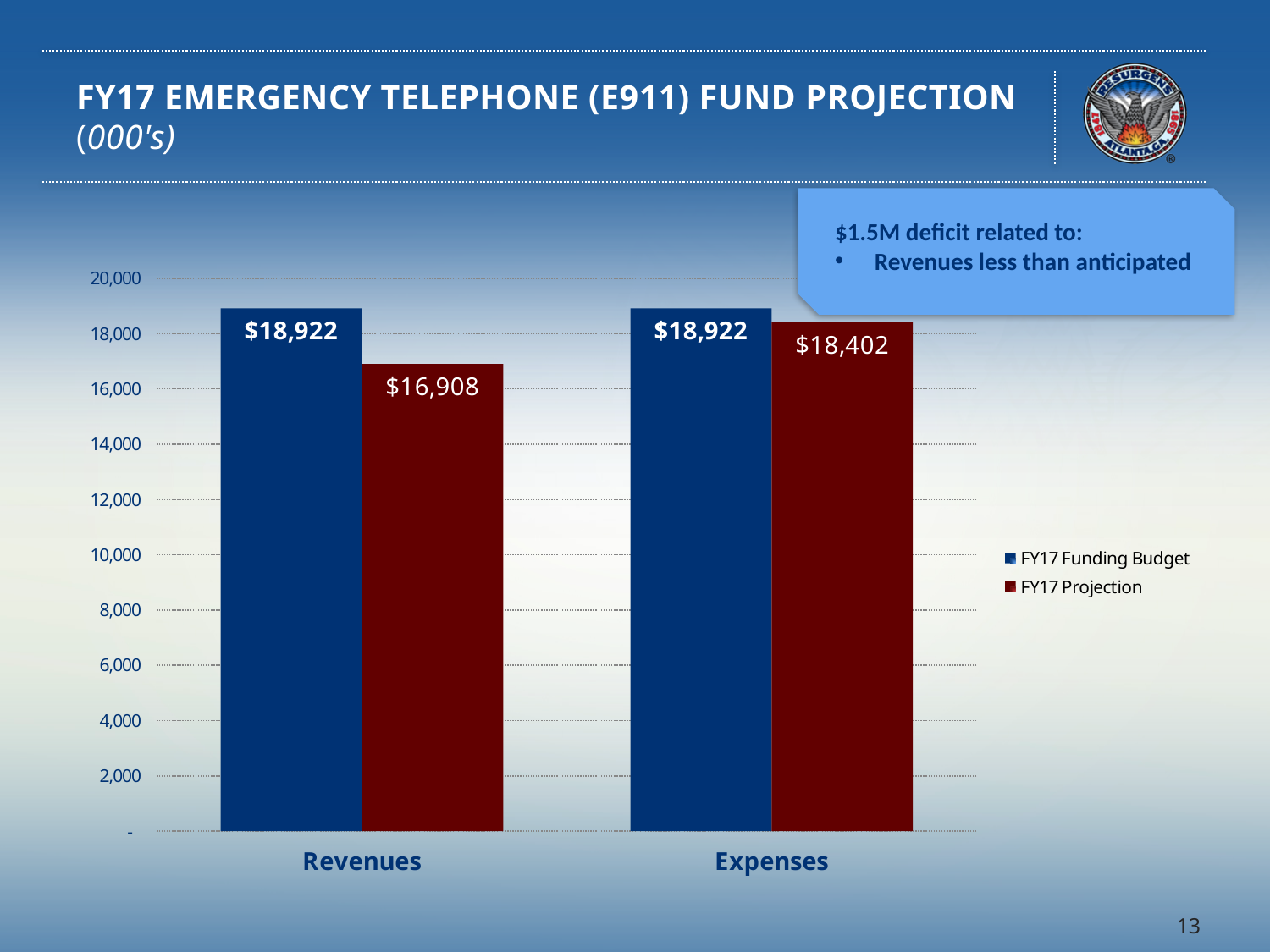
How many series does the legend list? 2 What is the FY17 Projection value for Expenses? $18,402 How many categories are shown on the x axis? 2 What is the difference between the FY17 Funding Budget and FY17 Projection for Revenues? $2,014 What kind of chart is shown on the slide? Bar chart Which category has the lowest FY17 Projection value? Revenues What is the FY17 Projection value for Revenues? $16,908 What is the FY17 Funding Budget value for Revenues? $18,922 Is the FY17 Projection value for Revenues greater or less than 18,000? less What is the difference between the FY17 Funding Budget and FY17 Projection for Expenses? $520 What is the FY17 Funding Budget value for Expenses? $18,922 Which is larger, the FY17 Projection for Revenues or the FY17 Projection for Expenses? FY17 Projection for Expenses